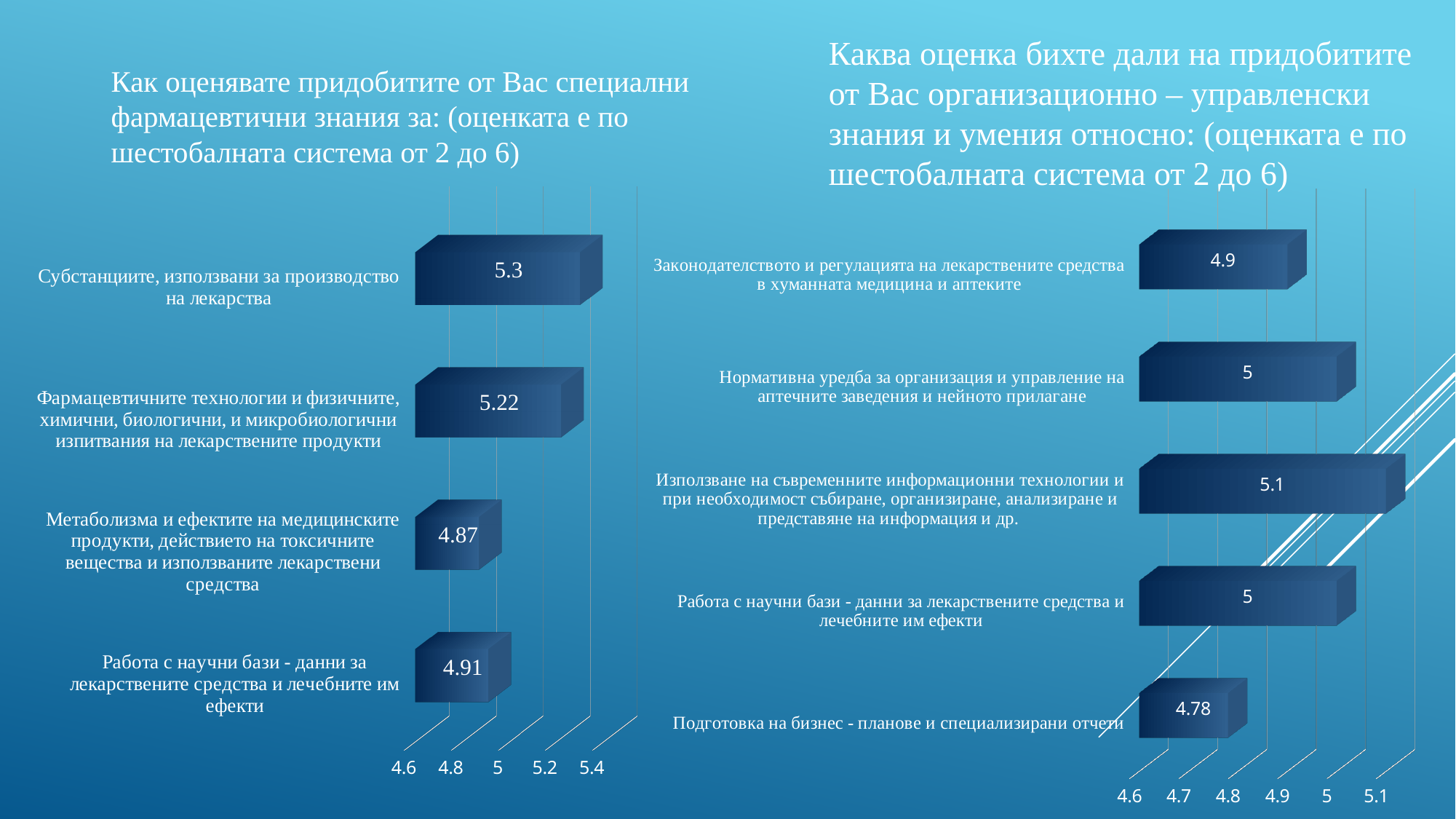
On the left chart, what is the value for "Метаболизма и ефектите на медицинските продукти, действието на токсичните вещества и използваните лекарствени средства"? 4.87 On the right chart, which category has the highest value? Използване на съвременните информационни технологии и при необходимост събиране, организиране, анализиране и представяне на информация и др. On the right chart, which category has the lowest value? Подготовка на бизнес - планове и специализирани отчети On the left chart, what is the value for "Субстанциите, използвани за производство на лекарства"? 5.3 On the right chart, what is the value for "Законодателството и регулацията на лекарствените средства в хуманната медицина и аптеките"? 4.9 On the left chart, what is the difference between the values for "Субстанциите, използвани за производство на лекарства" and "Фармацевтичните технологии и физичните, химични, биологични, и микробиологични изпитвания на лекарствените продукти"? 0.08 How many categories are shown on the right chart? 5 On the right chart, what is the value for "Подготовка на бизнес - планове и специализирани отчети"? 4.78 What type of chart is the right chart? Bar chart On the left chart, which category has the highest value? Субстанциите, използвани за производство на лекарства On the left chart, which category has the lowest value? Метаболизма и ефектите на медицинските продукти, действието на токсичните вещества и използваните лекарствени средства How many categories are shown on the left chart? 4